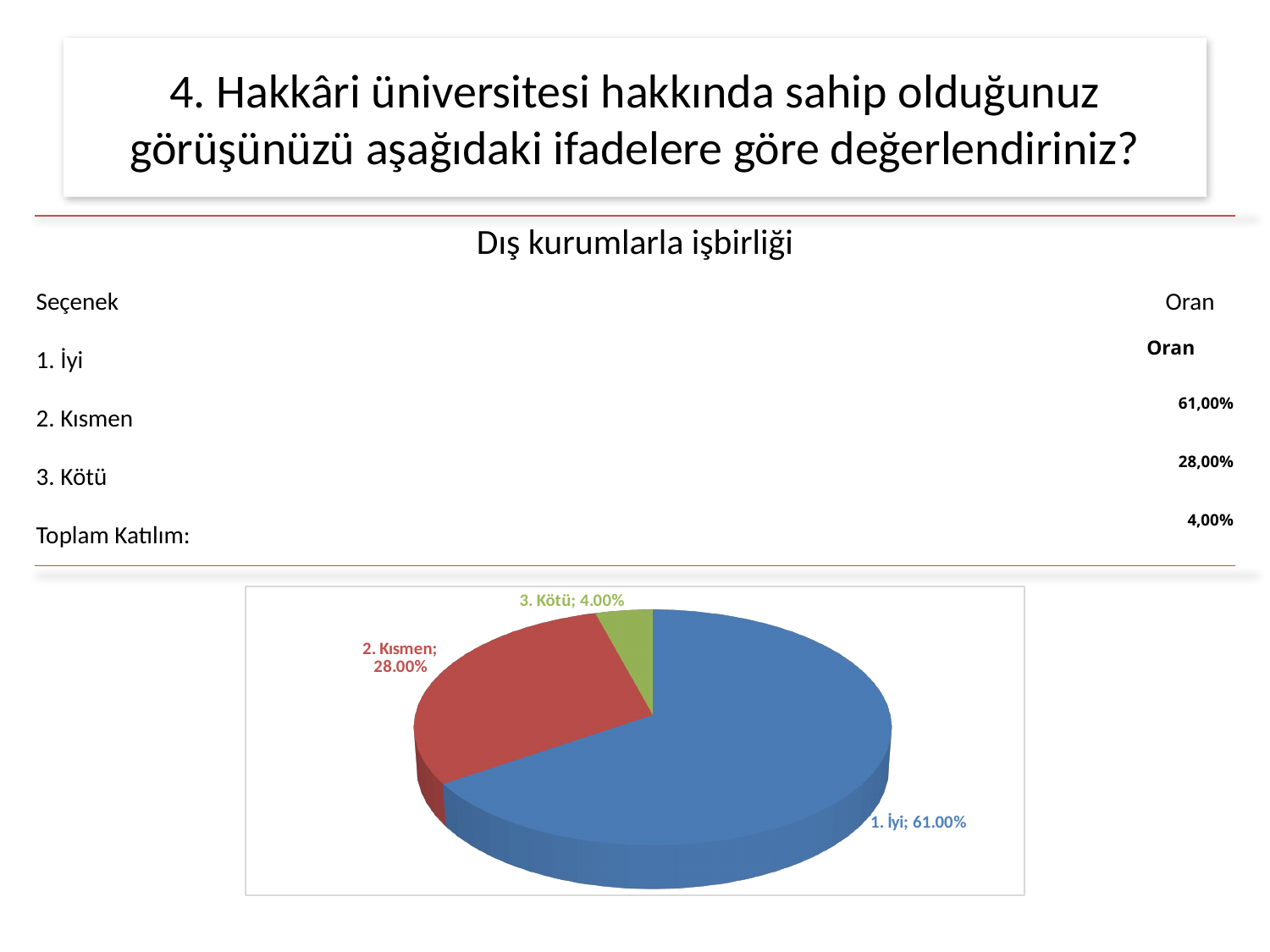
Which slice of the pie chart is the smallest? 3. Kötü Which is larger in the pie chart, "2. Kısmen" or "3. Kötü"? 2. Kısmen What is the value shown for "3. Kötü" in the pie chart? 4.00% What is the value shown for "2. Kısmen" in the pie chart? 28.00% What is the value shown for "1. İyi" in the pie chart? 61.00% Which slice of the pie chart is the largest? 1. İyi What kind of chart is shown on the slide? pie chart What colour is the "3. Kötü" slice in the pie chart? green What colour is the "1. İyi" slice in the pie chart? blue How many slices does the pie chart have? 3 What is the difference between the values for "2. Kısmen" and "3. Kötü" in the pie chart? 24.00% What is the difference between the values for "1. İyi" and "2. Kısmen" in the pie chart? 33.00%